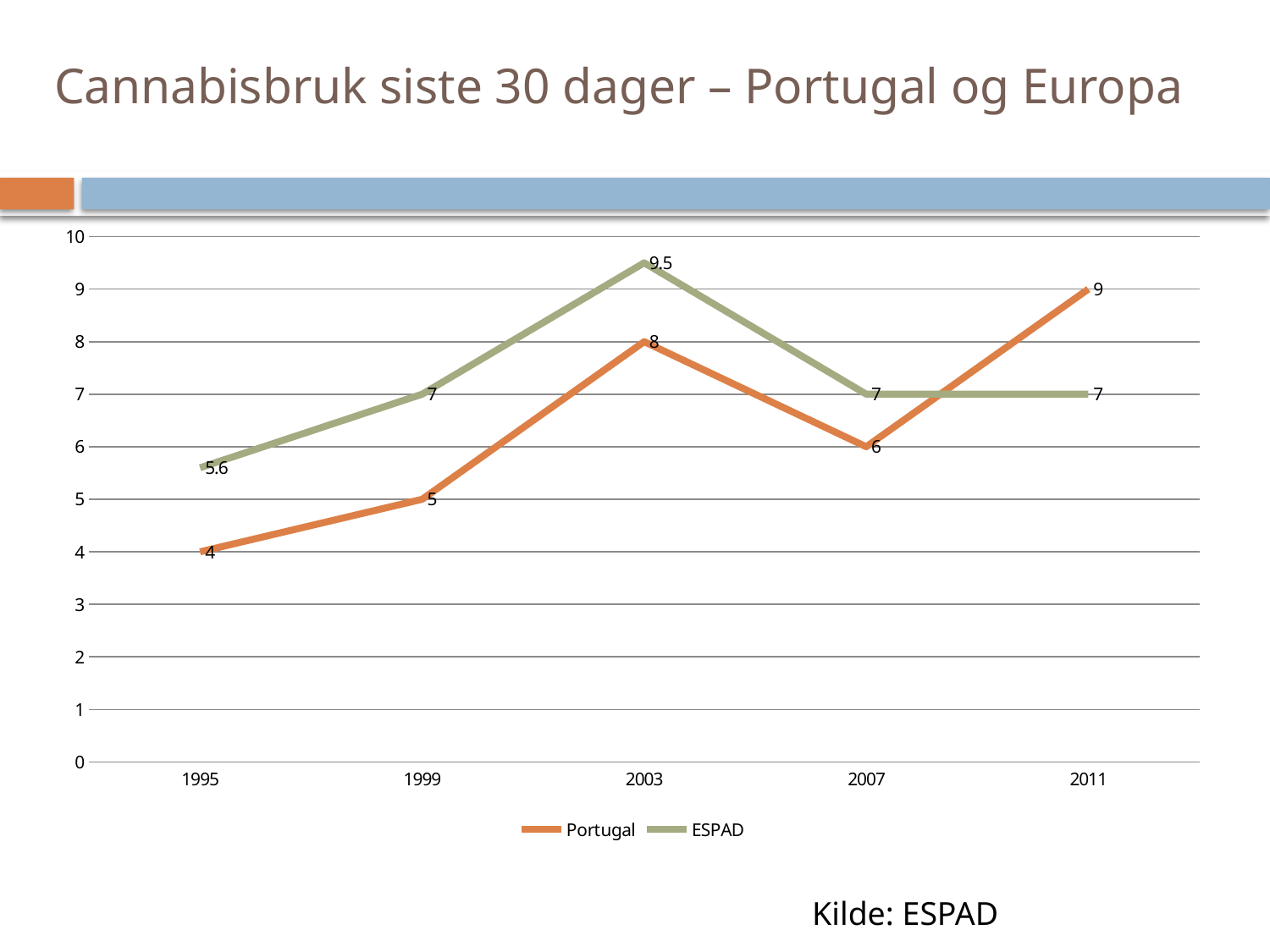
How many years are shown on the x axis? 5 What is the value for Portugal in 2003? 8 What is the value for Portugal in 2011? 9 Does the Portugal series rise or fall from 2007 to 2011? rise Is the value for ESPAD in 2003 greater or less than 9? greater How many series does the legend list? 2 In which year is the ESPAD series highest? 2003 What is the value for ESPAD in 1995? 5.6 What is the difference between the ESPAD and Portugal values in 2003? 1.5 What kind of chart is shown on the slide? line chart In which year is the Portugal series lowest? 1995 Which series has the larger value in 2011, Portugal or ESPAD? Portugal